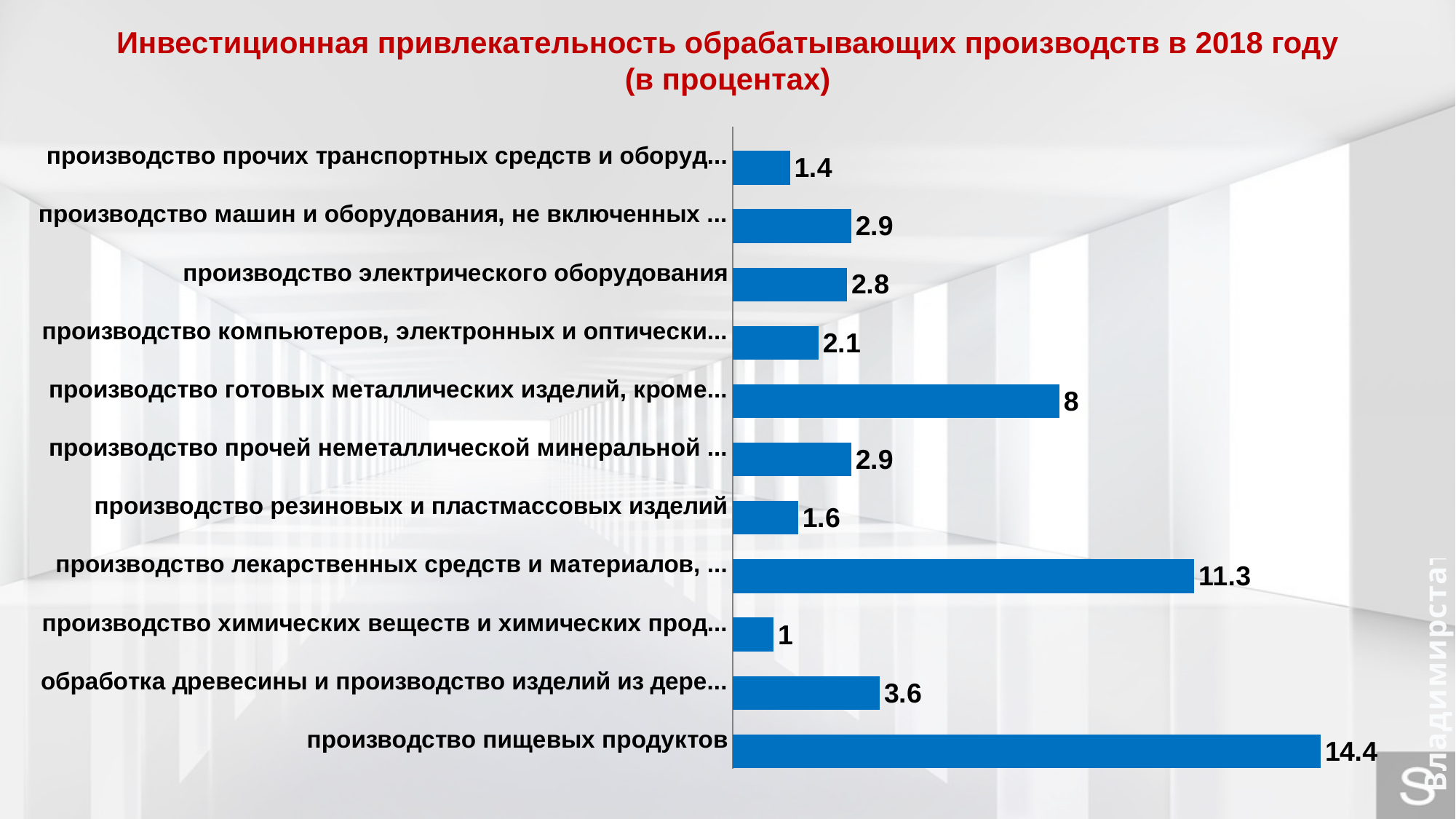
Which category has the highest value? производство пищевых продуктов How many categories are shown in the chart? 11 What is the difference between the values for производство пищевых продуктов and производство лекарственных средств и материалов? 3.1 What kind of chart is shown on the slide? Bar chart What value is shown for производство электрического оборудования? 2.8 What is the difference between the values for производство готовых металлических изделий and обработка древесины и производство изделий из дерева? 4.4 What value is shown for производство пищевых продуктов? 14.4 What value is shown for производство лекарственных средств и материалов? 11.3 What value is shown for обработка древесины и производство изделий из дерева? 3.6 What year does the chart title refer to? 2018 Which category has the lowest value? производство химических веществ и химических продуктов Which is larger: the value for производство электрического оборудования or for производство компьютеров, электронных и оптических изделий? производство электрического оборудования